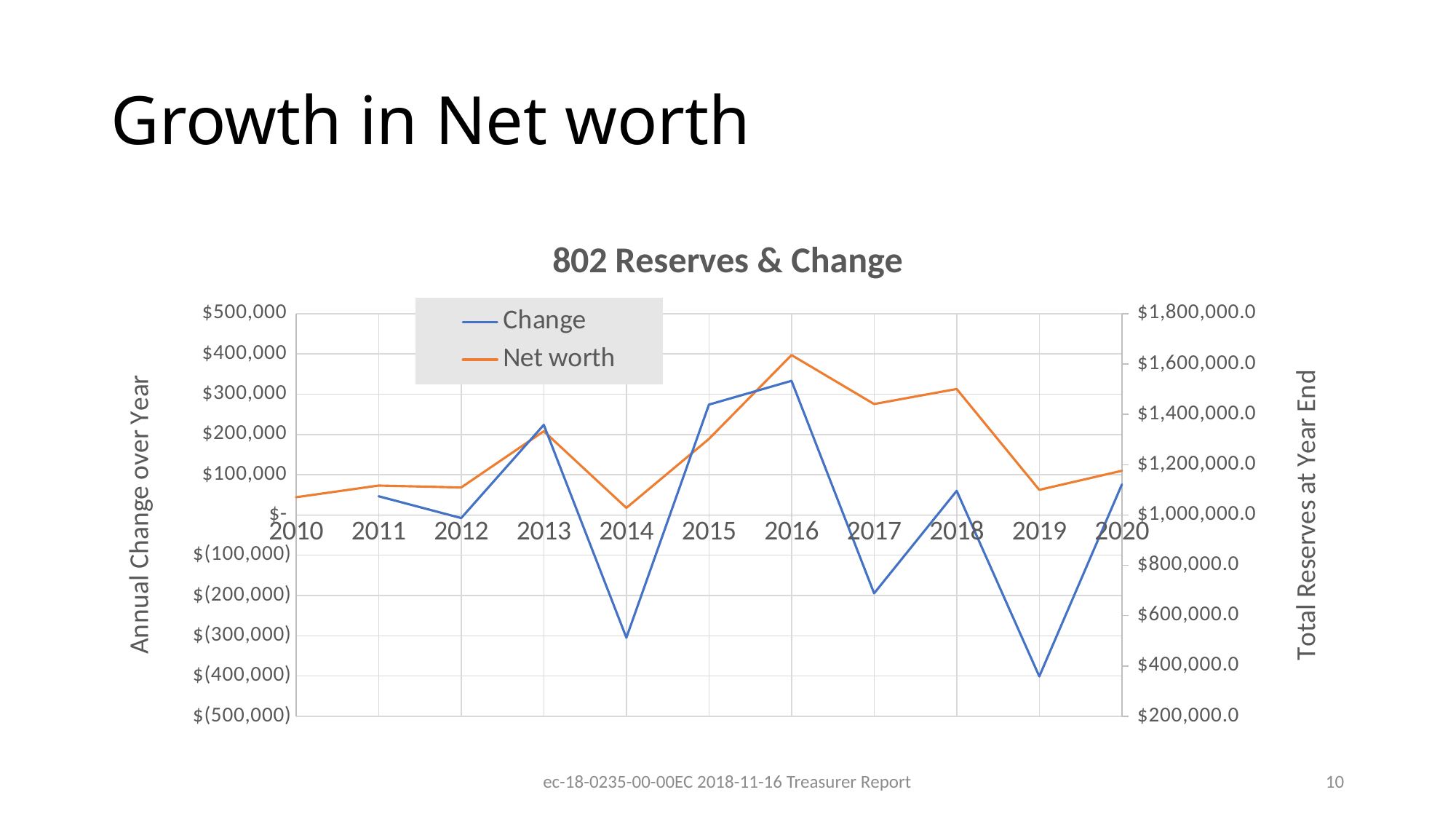
Is the value for Net worth in 2014 greater or less than $1,200,000.0? less Which year has the larger Net worth value, 2013 or 2015? 2013 Is the value for Net worth in 2016 greater or less than $1,400,000.0? greater How many series does the legend of the '802 Reserves & Change' chart list? 2 In which year is the Net worth series at its highest? 2016 In which year is the Change series at its highest? 2016 Does the Net worth series rise or fall from 2016 to 2019? Fall In which year is the Change series at its lowest? 2019 What kind of chart is shown on the slide? Line chart How many years are plotted along the x axis of the chart? 11 What is the title of the right-hand vertical axis? Total Reserves at Year End Is the value for Change in 2014 greater or less than $(200,000)? less